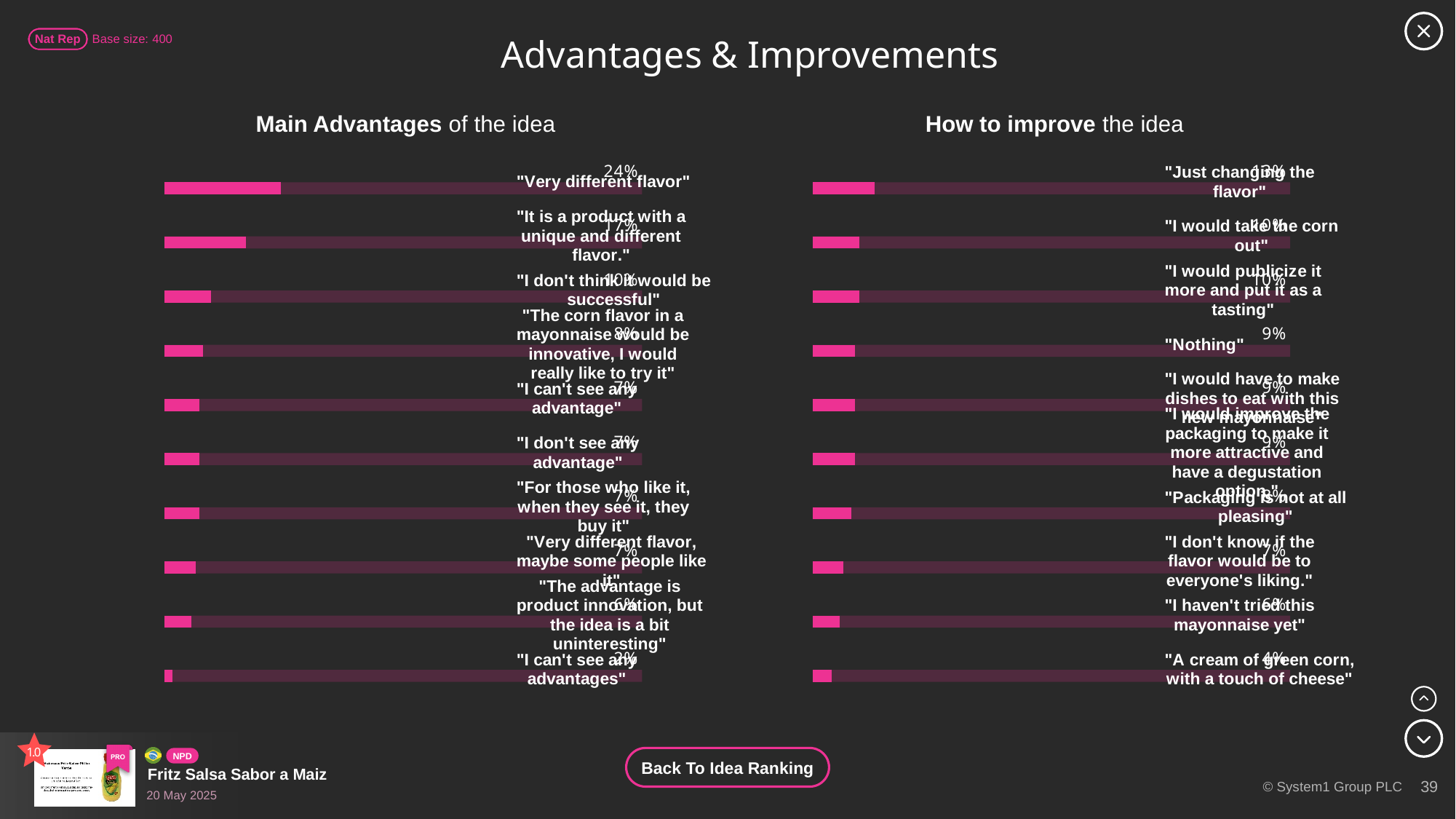
How many categories are shown in the "Main Advantages of the idea" chart? 10 In the "Main Advantages of the idea" chart, what is the difference between "Very different flavor" (24%) and "It is a product with a unique and different flavor." (17%)? 7% In the "Main Advantages of the idea" chart, which category has the highest value? "Very different flavor" In the "Main Advantages of the idea" chart, what percentage is shown for "Very different flavor"? 24% In the "How to improve the idea" chart, what percentage is shown for "Nothing"? 9% Which is larger: "Very different flavor" in the "Main Advantages of the idea" chart or "Just changing the flavor" in the "How to improve the idea" chart? "Very different flavor" In the "How to improve the idea" chart, which category has the highest value? "Just changing the flavor" How many categories are shown in the "How to improve the idea" chart? 10 In the "How to improve the idea" chart, what percentage is shown for "I haven't tried this mayonnaise yet"? 6% What type of chart is the "Main Advantages of the idea" chart? Bar chart In the "How to improve the idea" chart, which category has the lowest value? "A cream of green corn, with a touch of cheese" In the "Main Advantages of the idea" chart, which category has the lowest value? "I can't see any advantages"